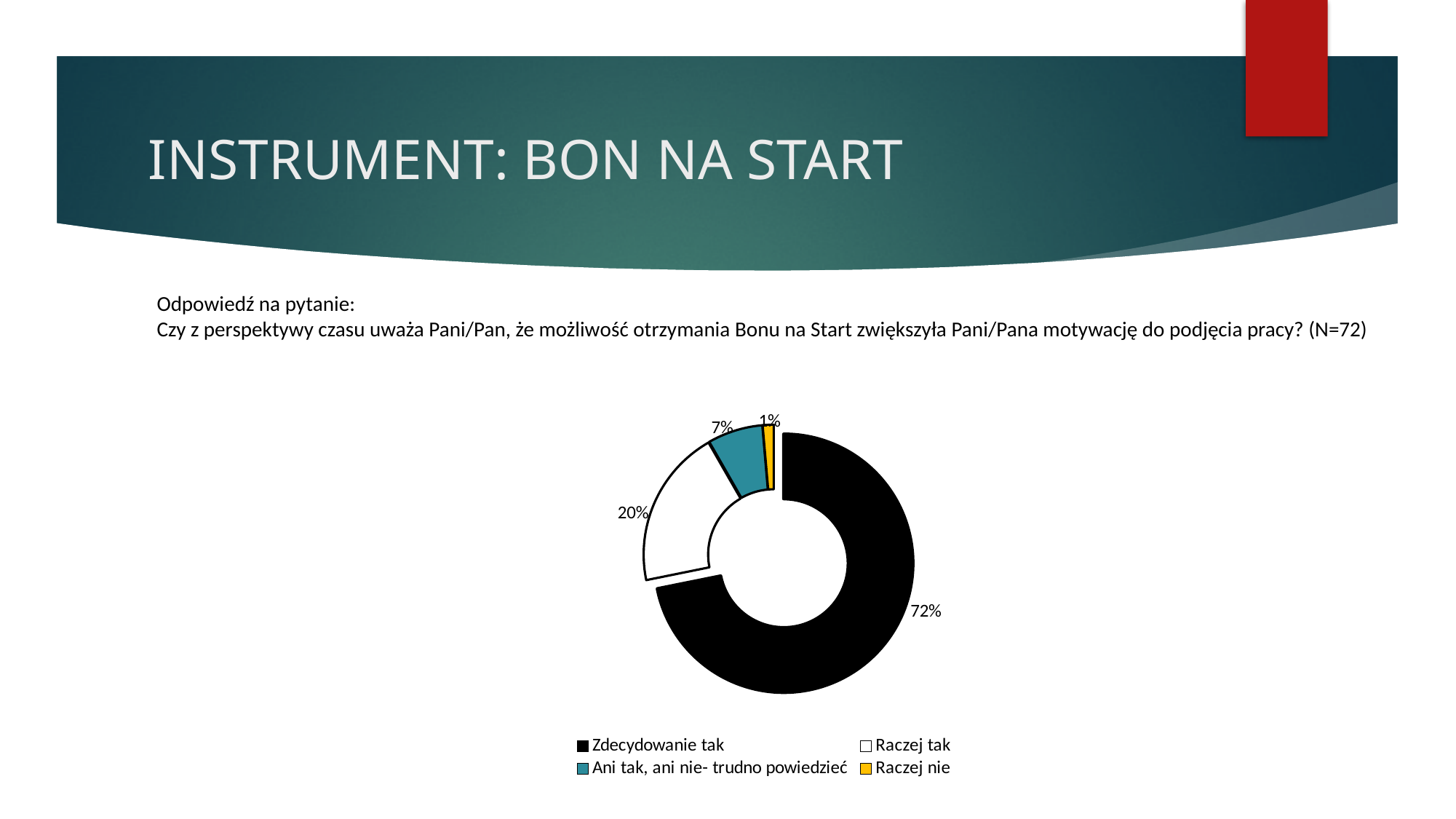
Which answer category has the smallest share of the chart? Raczej nie What percentage of respondents answered "Raczej nie"? 1% What colour is the slice for "Raczej nie"? Yellow/orange What kind of chart is shown on the slide? Doughnut (pie) chart What percentage of respondents answered "Zdecydowanie tak"? 72% How many entries does the chart legend list? 4 How many answer categories are shown in the chart? 4 What is the difference in percentage points between "Zdecydowanie tak" and "Raczej tak"? 52 Which is larger: the share for "Raczej tak" or the share for "Ani tak, ani nie- trudno powiedzieć"? Raczej tak Which answer category has the largest share of the chart? Zdecydowanie tak What percentage of respondents answered "Raczej tak"? 20% What percentage of respondents answered "Ani tak, ani nie- trudno powiedzieć"? 7%